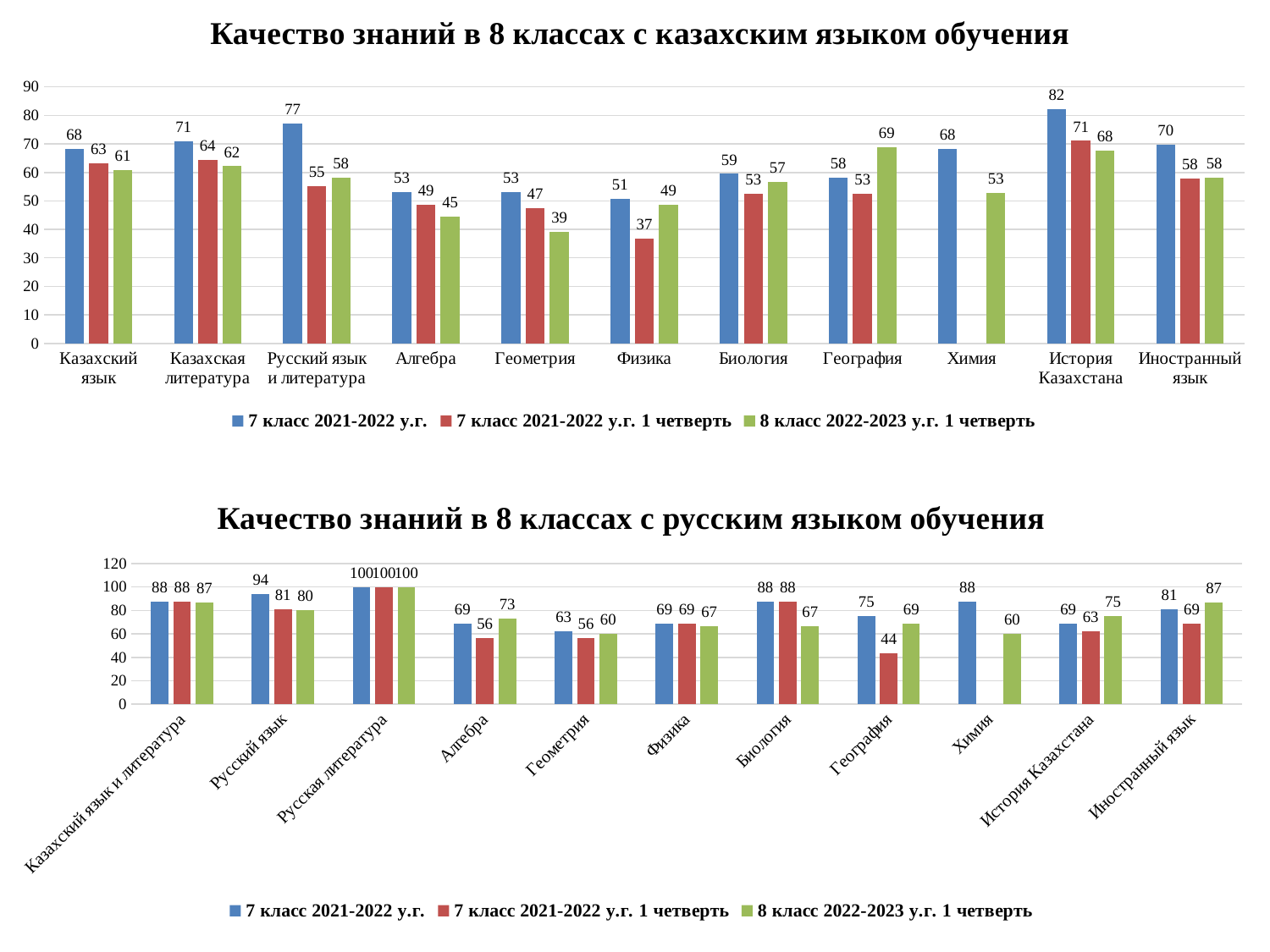
In the chart 'Качество знаний в 8 классах с русским языком обучения', what is the difference between the '7 класс 2021-2022 у.г.' value and the '8 класс 2022-2023 у.г. 1 четверть' value for Химия? 28 In the chart 'Качество знаний в 8 классах с казахским языком обучения', how many series does the legend list? 3 In the chart 'Качество знаний в 8 классах с русским языком обучения', which is larger for Иностранный язык: the '7 класс 2021-2022 у.г.' value or the '8 класс 2022-2023 у.г. 1 четверть' value? 8 класс 2022-2023 у.г. 1 четверть In the chart 'Качество знаний в 8 классах с казахским языком обучения', which category has no bar for the series '7 класс 2021-2022 у.г. 1 четверть'? Химия In the chart 'Качество знаний в 8 классах с русским языком обучения', what is the value for География in the series '7 класс 2021-2022 у.г. 1 четверть'? 44 In the chart 'Качество знаний в 8 классах с казахским языком обучения', what is the value for Физика in the series '7 класс 2021-2022 у.г. 1 четверть'? 37 In the chart 'Качество знаний в 8 классах с казахским языком обучения', which category has the lowest value in the series '8 класс 2022-2023 у.г. 1 четверть'? Геометрия In the chart 'Качество знаний в 8 классах с казахским языком обучения', what is the value for История Казахстана in the series '7 класс 2021-2022 у.г.'? 82 In the chart 'Качество знаний в 8 классах с казахским языком обучения', how many subject categories are shown on the x axis? 11 In the chart 'Качество знаний в 8 классах с русским языком обучения', which category has the highest value in the series '8 класс 2022-2023 у.г. 1 четверть'? Русская литература In the chart 'Качество знаний в 8 классах с казахским языком обучения', what is the difference between the '7 класс 2021-2022 у.г.' value and the '8 класс 2022-2023 у.г. 1 четверть' value for Русский язык и литература? 19 What kind of chart is 'Качество знаний в 8 классах с русским языком обучения'? Bar chart